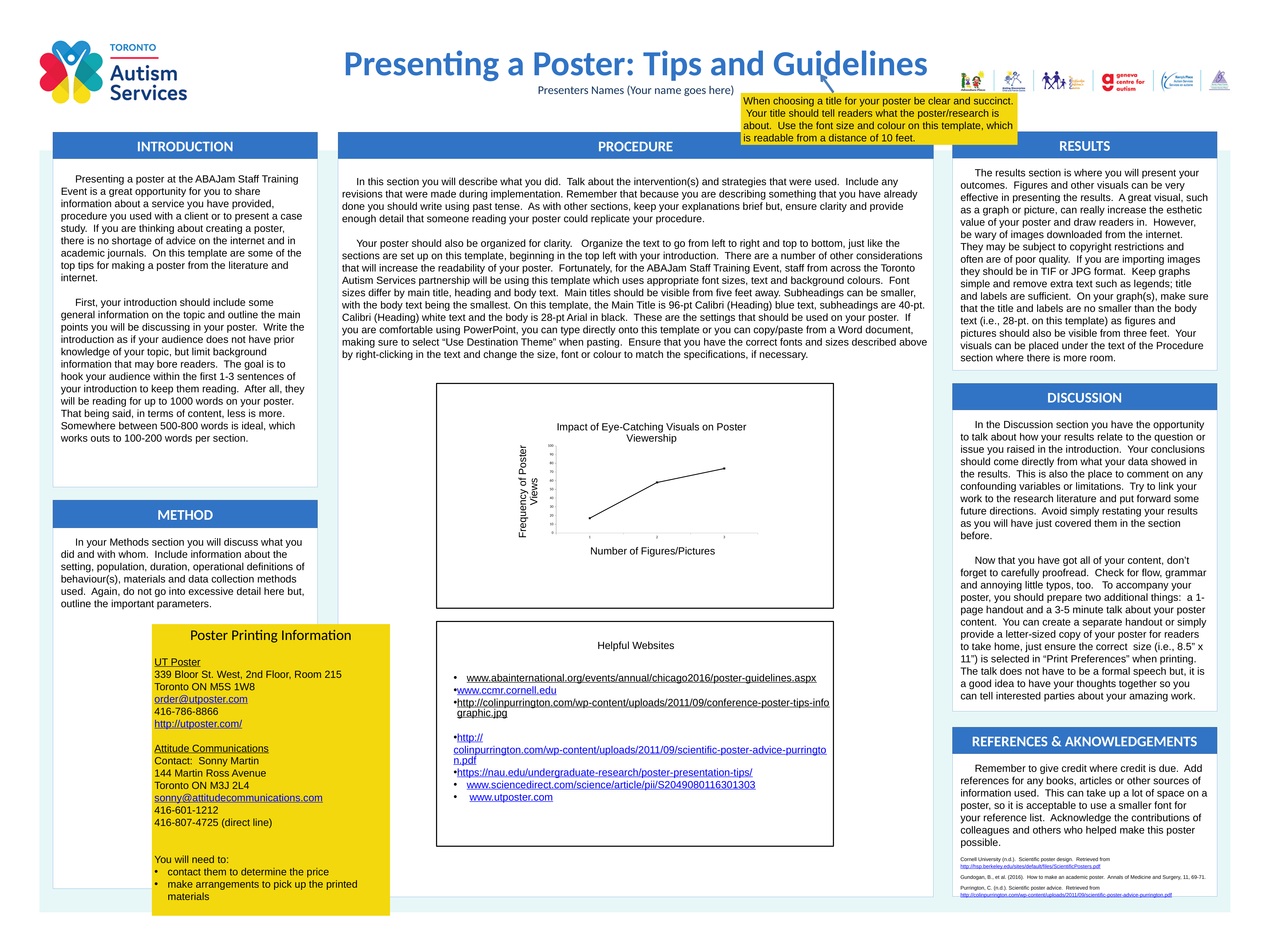
Is the frequency of poster views for 3 figures/pictures greater or less than 70? greater What is the title of the chart on the slide? Impact of Eye-Catching Visuals on Poster Viewership Which has a higher frequency of poster views: 1 figure/picture or 2 figures/pictures? 2 figures/pictures How many data points are plotted on the chart? 3 Do the values rise or fall as the number of figures/pictures increases? rise Is the frequency of poster views for 1 figure/picture greater or less than 30? less Is the frequency of poster views for 3 figures/pictures greater or less than 80? less What is the x-axis label of the chart? Number of Figures/Pictures What kind of chart is shown on the slide? line chart Which number of figures/pictures has the lowest frequency of poster views? 1 Which number of figures/pictures has the highest frequency of poster views? 3